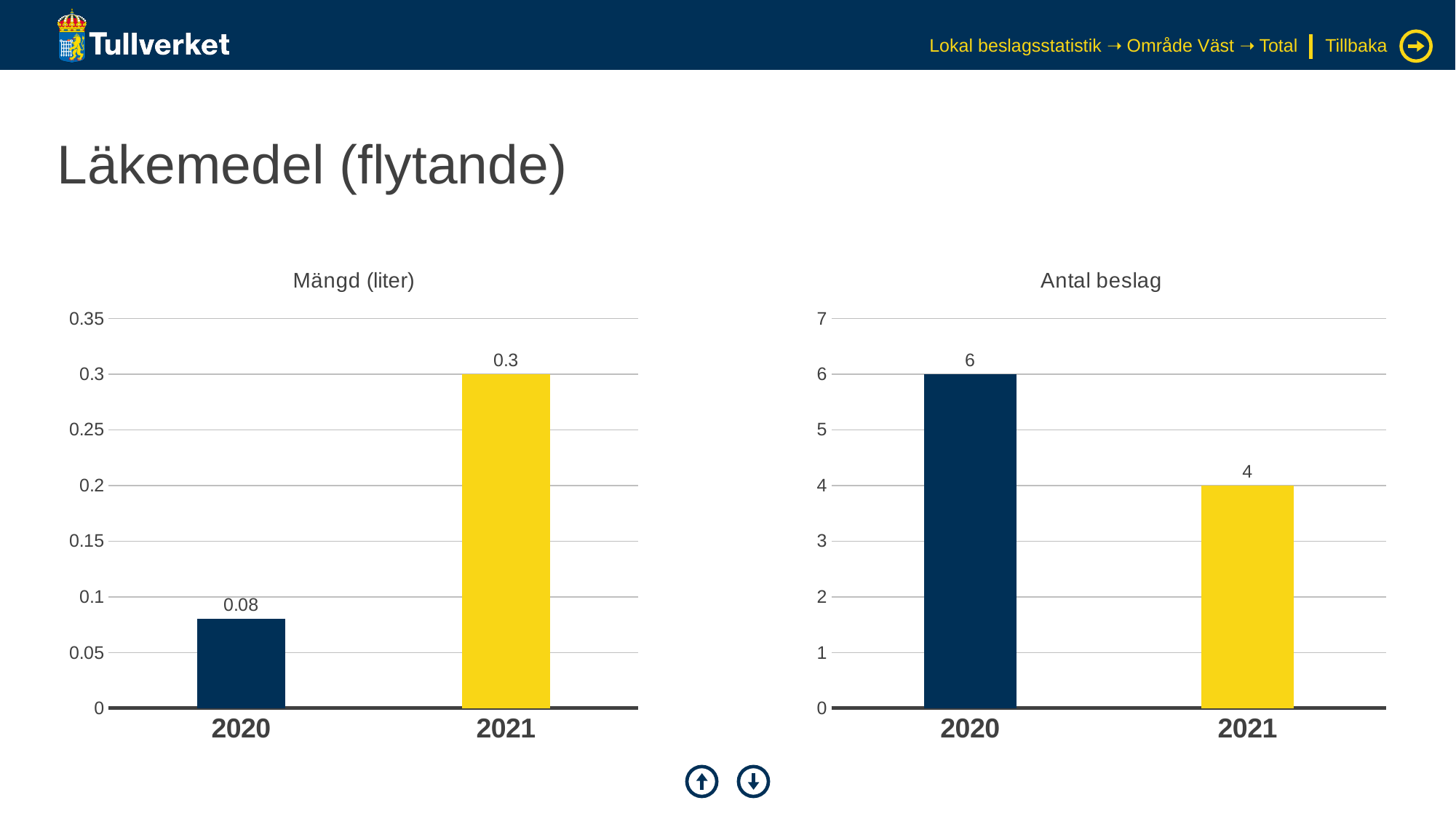
In the 'Mängd (liter)' chart, what is the value for 2021? 0.3 In the 'Antal beslag' chart, what is the value for 2020? 6 In the 'Mängd (liter)' chart, how many categories are shown on the x axis? 2 In the 'Mängd (liter)' chart, what is the difference between the values for 2021 and 2020? 0.22 In the 'Antal beslag' chart, what is the value for 2021? 4 In the 'Antal beslag' chart, is the value for 2020 greater or less than 5? greater In the 'Antal beslag' chart, which year has the lowest value? 2021 In the 'Antal beslag' chart, do the values rise or fall from 2020 to 2021? Fall In the 'Antal beslag' chart, what is the difference between the values for 2020 and 2021? 2 In the 'Mängd (liter)' chart, which year has the highest value? 2021 In the 'Mängd (liter)' chart, what is the value for 2020? 0.08 What kind of chart is the 'Antal beslag' chart? Bar chart